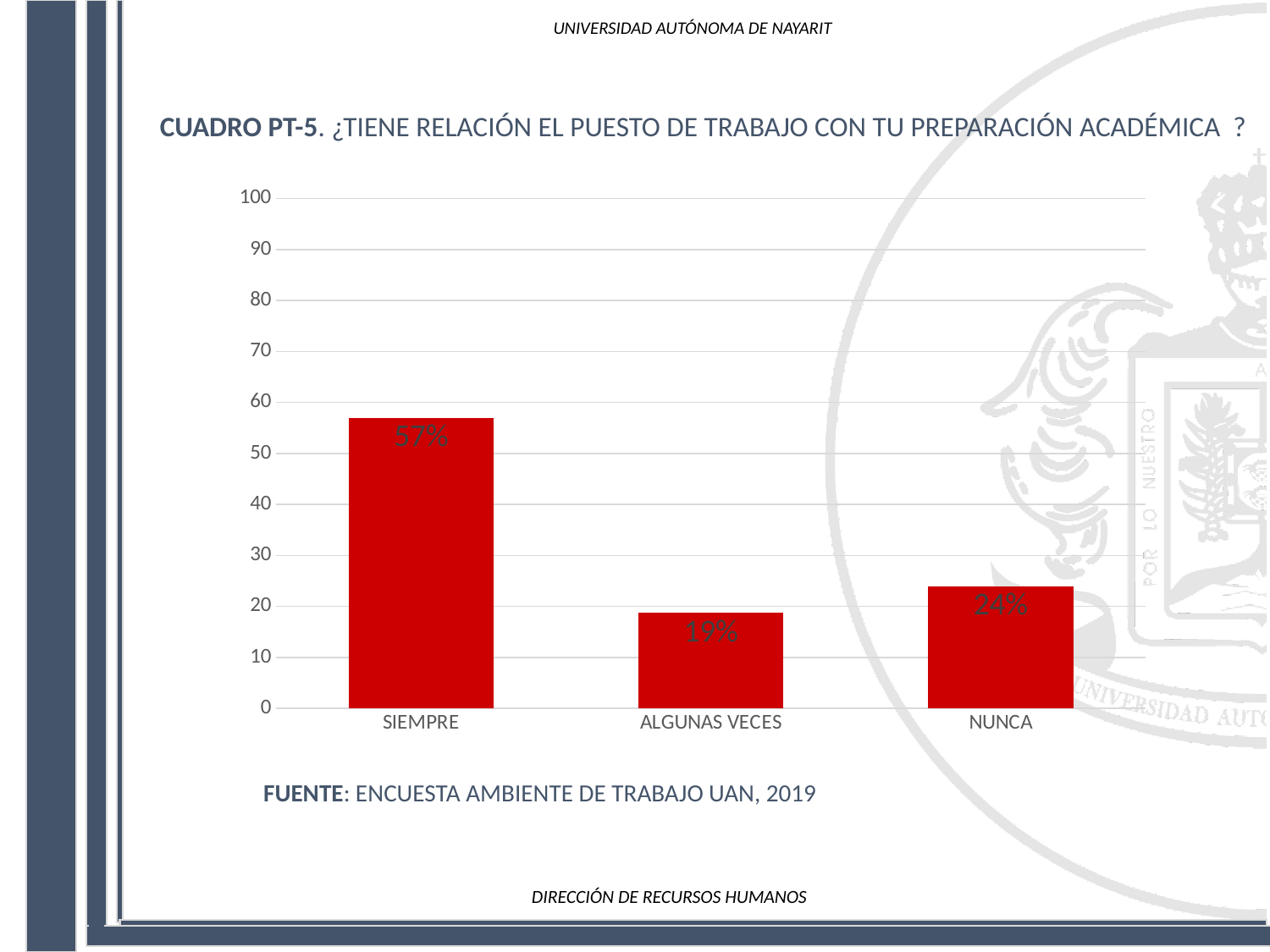
Is the value for SIEMPRE greater or less than 50? greater Which category has the lowest value? ALGUNAS VECES What is the difference between the values for SIEMPRE and NUNCA? 33% Which category has the highest value? SIEMPRE What is the value for ALGUNAS VECES? 19% What is the value for SIEMPRE? 57% What is the difference between the values for NUNCA and ALGUNAS VECES? 5% What kind of chart is shown on the slide? bar chart What source is cited below the chart? ENCUESTA AMBIENTE DE TRABAJO UAN, 2019 How many categories are shown on the x axis? 3 What is the value for NUNCA? 24% Which is larger, the value for NUNCA or the value for ALGUNAS VECES? NUNCA